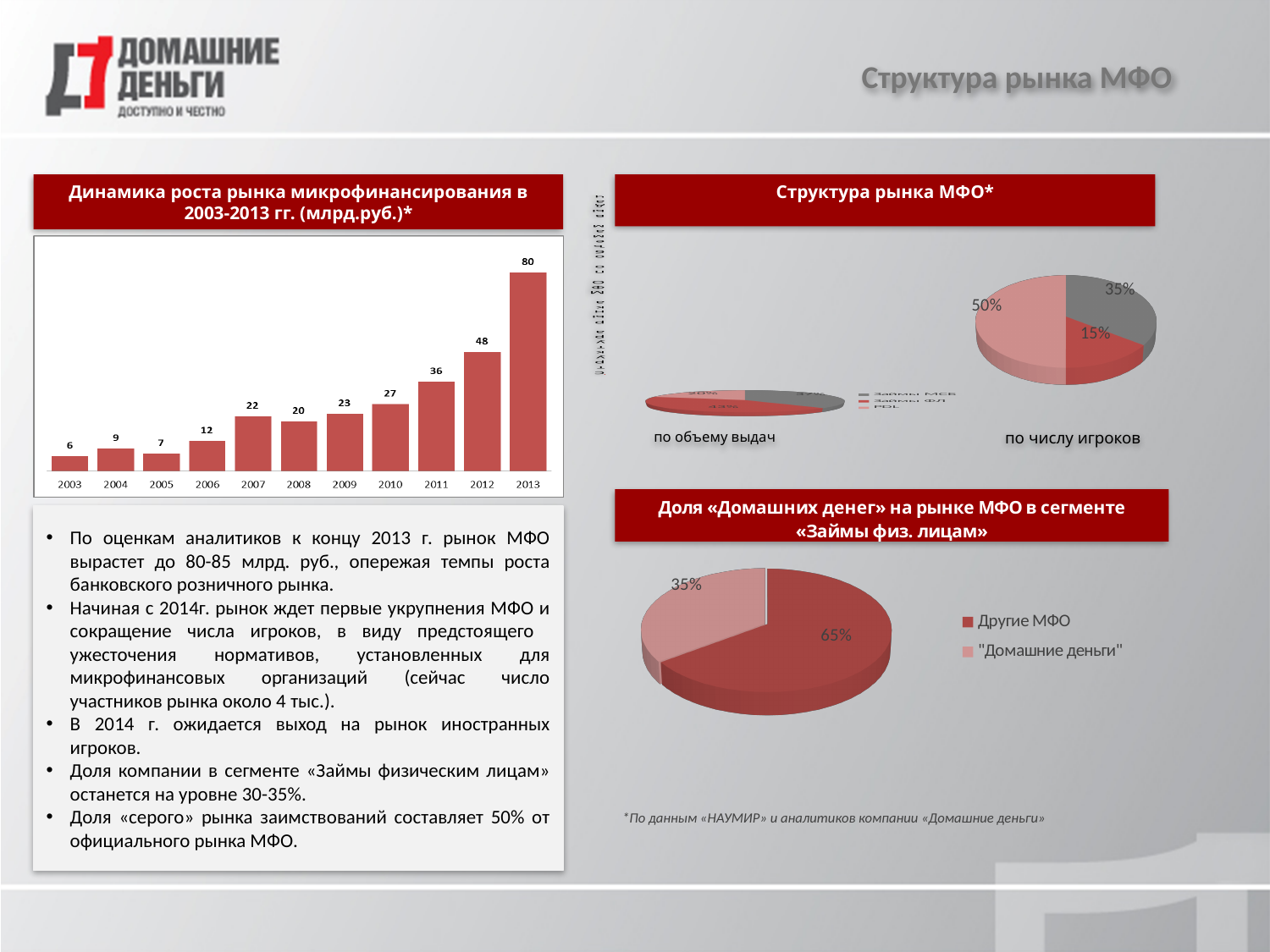
How many entries does the legend of the pie chart 'Доля «Домашних денег» на рынке МФО в сегменте «Займы физ. лицам»' list? 2 In the bar chart 'Динамика роста рынка микрофинансирования в 2003-2013 гг.', what is the difference between the values for 2013 and 2012? 32 In the bar chart 'Динамика роста рынка микрофинансирования в 2003-2013 гг.', which is larger, the value for 2008 or the value for 2009? 2009 How many years are shown in the bar chart 'Динамика роста рынка микрофинансирования в 2003-2013 гг.'? 11 In the bar chart 'Динамика роста рынка микрофинансирования в 2003-2013 гг.', which year has the highest value? 2013 In the bar chart 'Динамика роста рынка микрофинансирования в 2003-2013 гг.', what is the value for 2007? 22 In the bar chart 'Динамика роста рынка микрофинансирования в 2003-2013 гг.', what is the value for 2013? 80 In the bar chart 'Динамика роста рынка микрофинансирования в 2003-2013 гг.', which year has the lowest value? 2003 In the pie chart 'Доля «Домашних денег» на рынке МФО в сегменте «Займы физ. лицам»', what share does 'Другие МФО' have? 65% What kind of chart is 'Динамика роста рынка микрофинансирования в 2003-2013 гг.'? bar chart In the pie chart labelled 'по числу игроков' under 'Структура рынка МФО*', what is the largest share shown? 50% In the pie chart 'Доля «Домашних денег» на рынке МФО в сегменте «Займы физ. лицам»', what share does '"Домашние деньги"' have? 35%